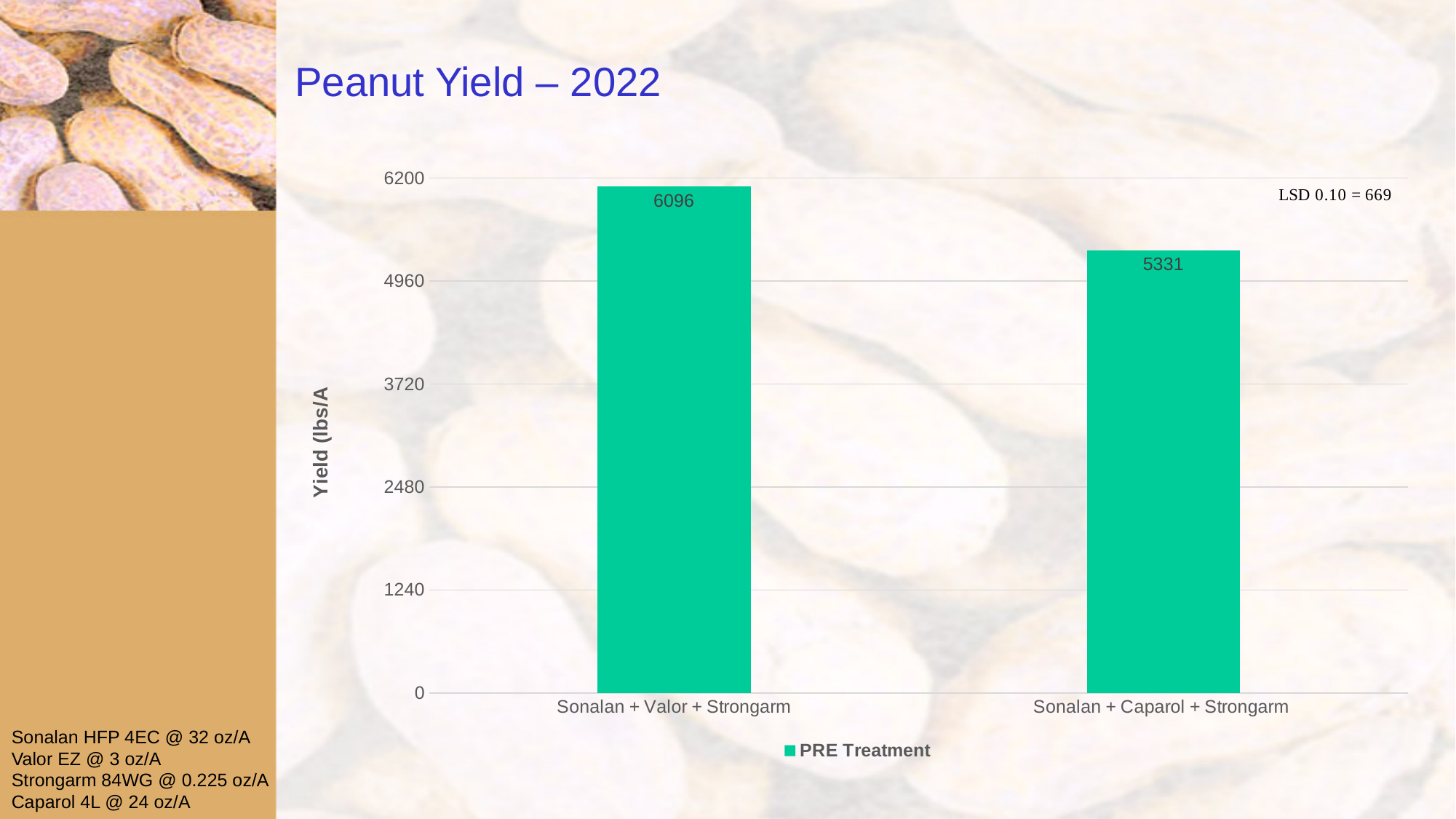
Which treatment has the highest yield? Sonalan + Valor + Strongarm How many treatments are shown on the chart? 2 What is the yield for Sonalan + Valor + Strongarm? 6096 What kind of chart is shown on the slide? bar chart What is the label of the y axis? Yield (lbs/A) What is the yield for Sonalan + Caparol + Strongarm? 5331 How many series does the legend list? 1 Which treatment has the lowest yield? Sonalan + Caparol + Strongarm What is the title of the chart? Peanut Yield – 2022 Is the yield for Sonalan + Caparol + Strongarm greater or less than 4960? greater What is the difference in yield between Sonalan + Valor + Strongarm and Sonalan + Caparol + Strongarm? 765 Which has a larger yield, Sonalan + Valor + Strongarm or Sonalan + Caparol + Strongarm? Sonalan + Valor + Strongarm